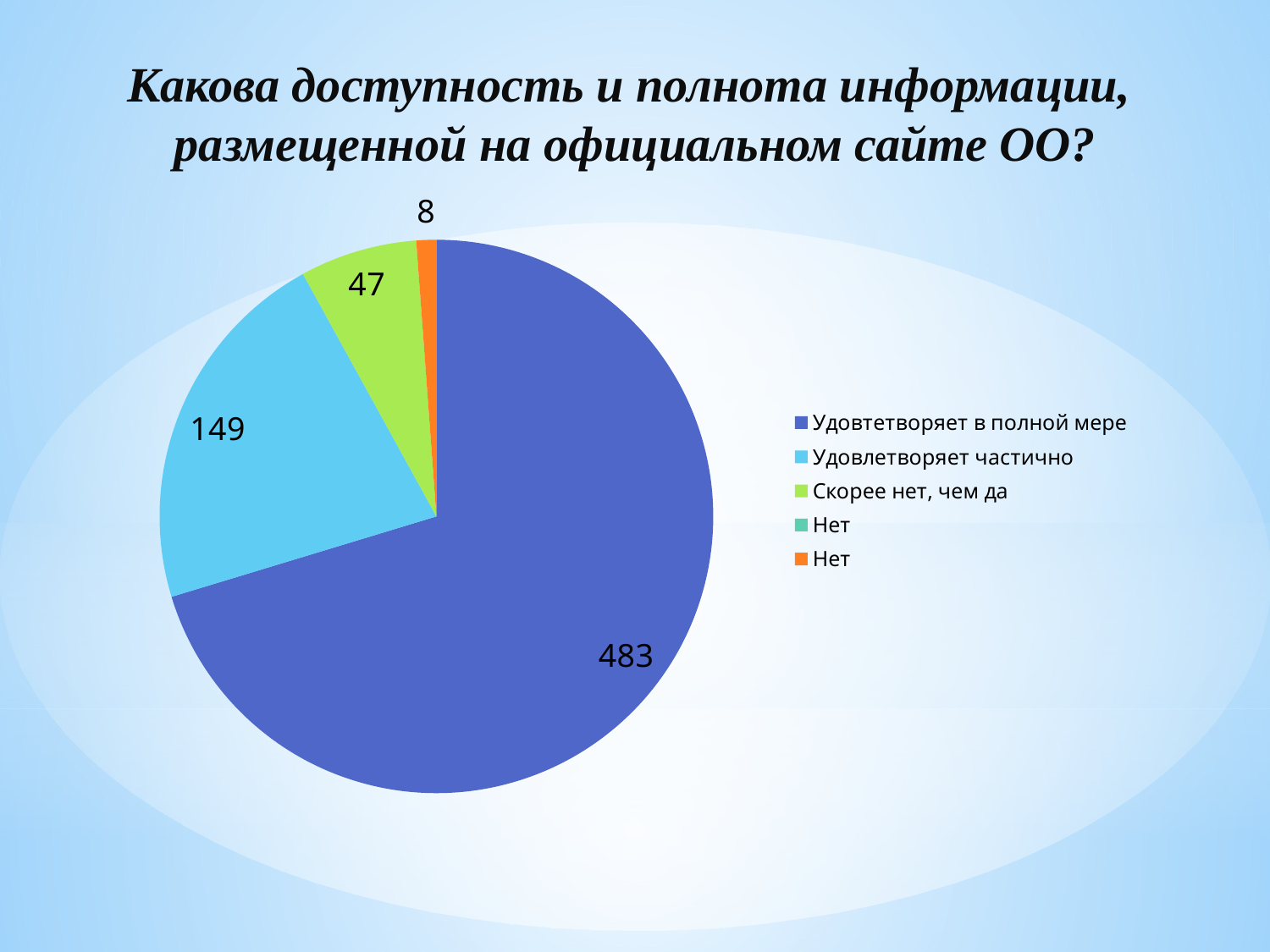
What is the value for "Скорее нет, чем да"? 47 Which of the labelled slices has the smallest value? Нет How many entries does the legend list? 5 What is the difference between the values for "Удовтетворяет в полной мере" and "Удовлетворяет частично"? 334 Which is larger, the value for "Удовлетворяет частично" or the value for "Скорее нет, чем да"? Удовлетворяет частично What colour is the slice for "Удовлетворяет частично"? light blue What is the value for "Удовтетворяет в полной мере"? 483 What is the difference between the values for "Удовлетворяет частично" and "Скорее нет, чем да"? 102 What is the value for "Удовлетворяет частично"? 149 What is the value shown on the smallest visible slice of the pie? 8 Which category has the largest slice of the pie? Удовтетворяет в полной мере What kind of chart is shown on the slide? pie chart